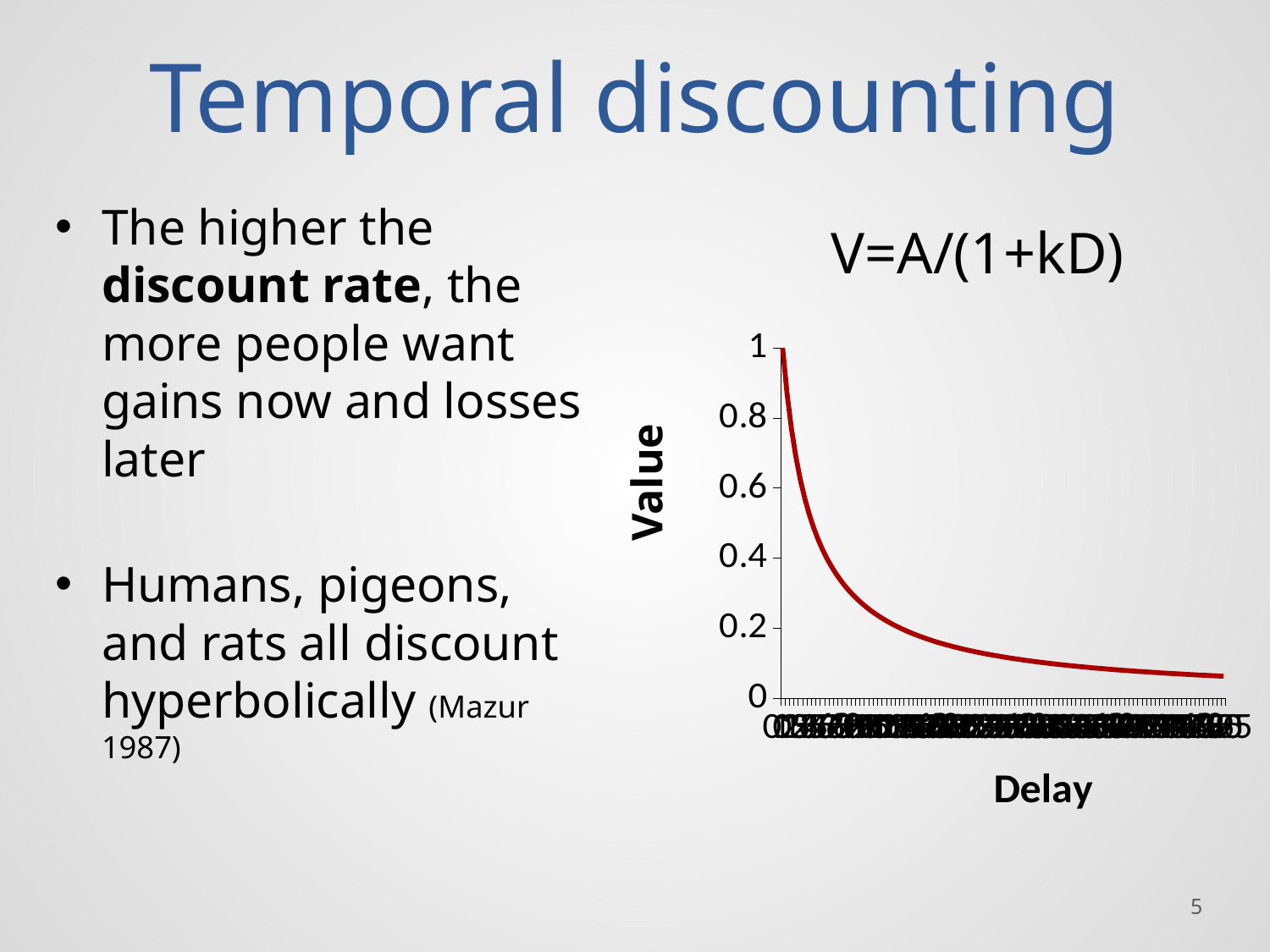
Is the value at the far right end of the curve greater or less than 0.2? less Is the value at the far right end of the curve greater or less than 0.4? less How many lines are plotted on the chart? 1 What is the label of the vertical axis of the chart? Value What kind of chart is shown on the slide? line chart What is the highest tick value shown on the Value axis? 1 Is the value at the start of the curve (leftmost point) greater or less than 0.8? greater Which is larger, the value at the left end of the curve or the value at the right end of the curve? the left end What is the title of the chart? V=A/(1+kD) Does the plotted value rise or fall as Delay increases along the x axis? fall What is the highest value the curve reaches on the Value axis, at the start of the curve? 1